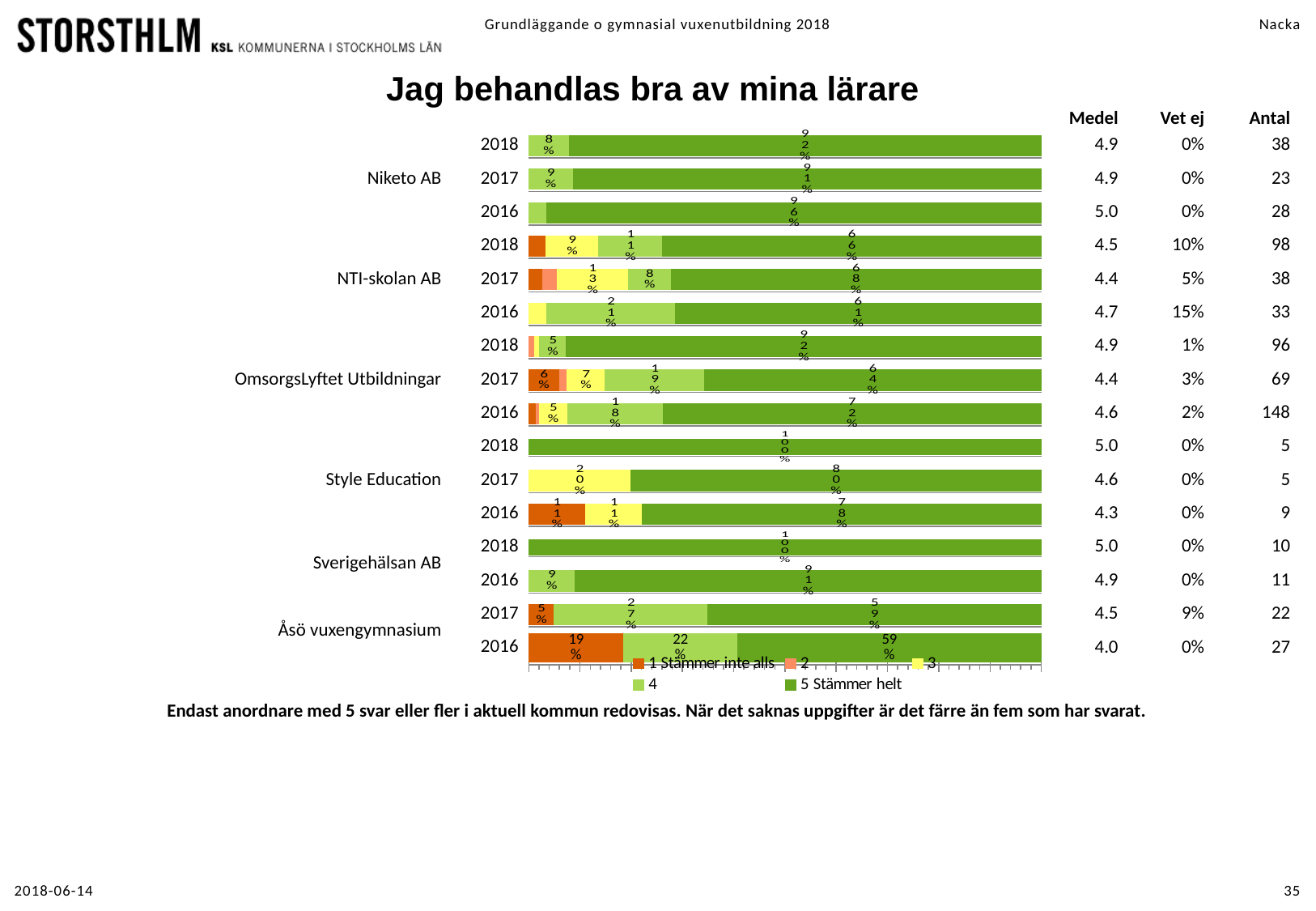
What share of NTI-skolan AB 2017 responses is '5 Stämmer helt'? 68% How many education providers are listed on the chart? 6 What share of Åsö vuxengymnasium 2016 responses is '5 Stämmer helt'? 59% Which bar has the largest '1 Stämmer inte alls' share? Åsö vuxengymnasium 2016 How many series does the chart legend list? 5 Which has a larger '5 Stämmer helt' share: Niketo AB 2018 or Åsö vuxengymnasium 2016? Niketo AB 2018 For Åsö vuxengymnasium 2016, what is the difference in percentage points between the '5 Stämmer helt' share and the '4' share? 37 What share of Åsö vuxengymnasium 2016 responses is '1 Stämmer inte alls'? 19% What is the title of the chart? Jag behandlas bra av mina lärare What kind of chart is shown on the slide? bar chart What share of Niketo AB 2016 responses is '5 Stämmer helt'? 96% What share of Style Education 2017 responses is '3'? 20%